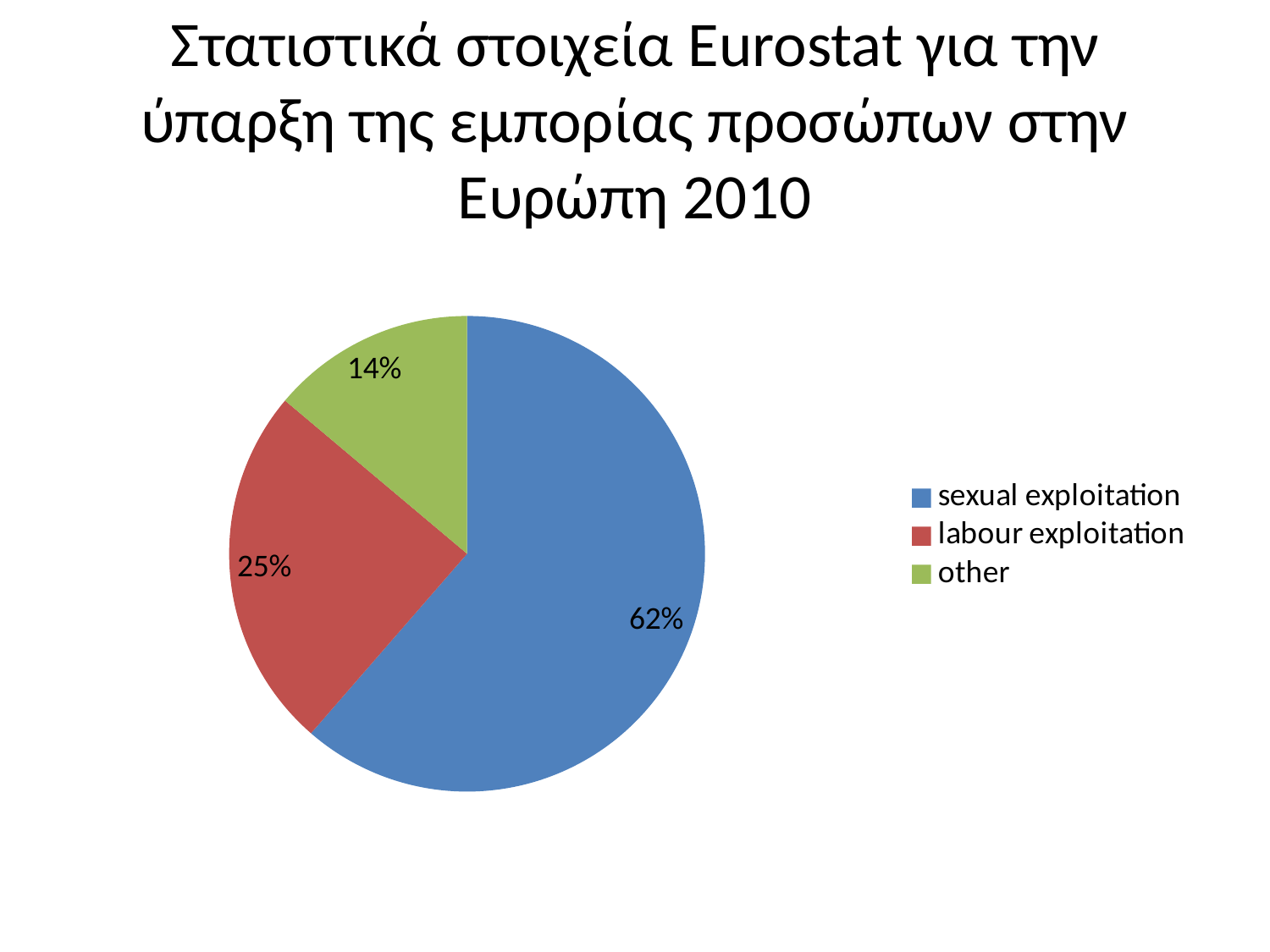
Which is larger, the share for labour exploitation or the share for other? labour exploitation What colour is the slice for labour exploitation? red What share of the pie does the 'other' slice account for? 14% Which category has the smallest slice of the pie? other What kind of chart is shown on the slide? pie chart What share of the pie does labour exploitation account for? 25% What is the difference in percentage points between labour exploitation and other? 11 How many slices does the pie chart have? 3 What is the difference in percentage points between sexual exploitation and labour exploitation? 37 How many entries does the legend list? 3 What share of the pie does sexual exploitation account for? 62% Which category has the largest slice of the pie? sexual exploitation